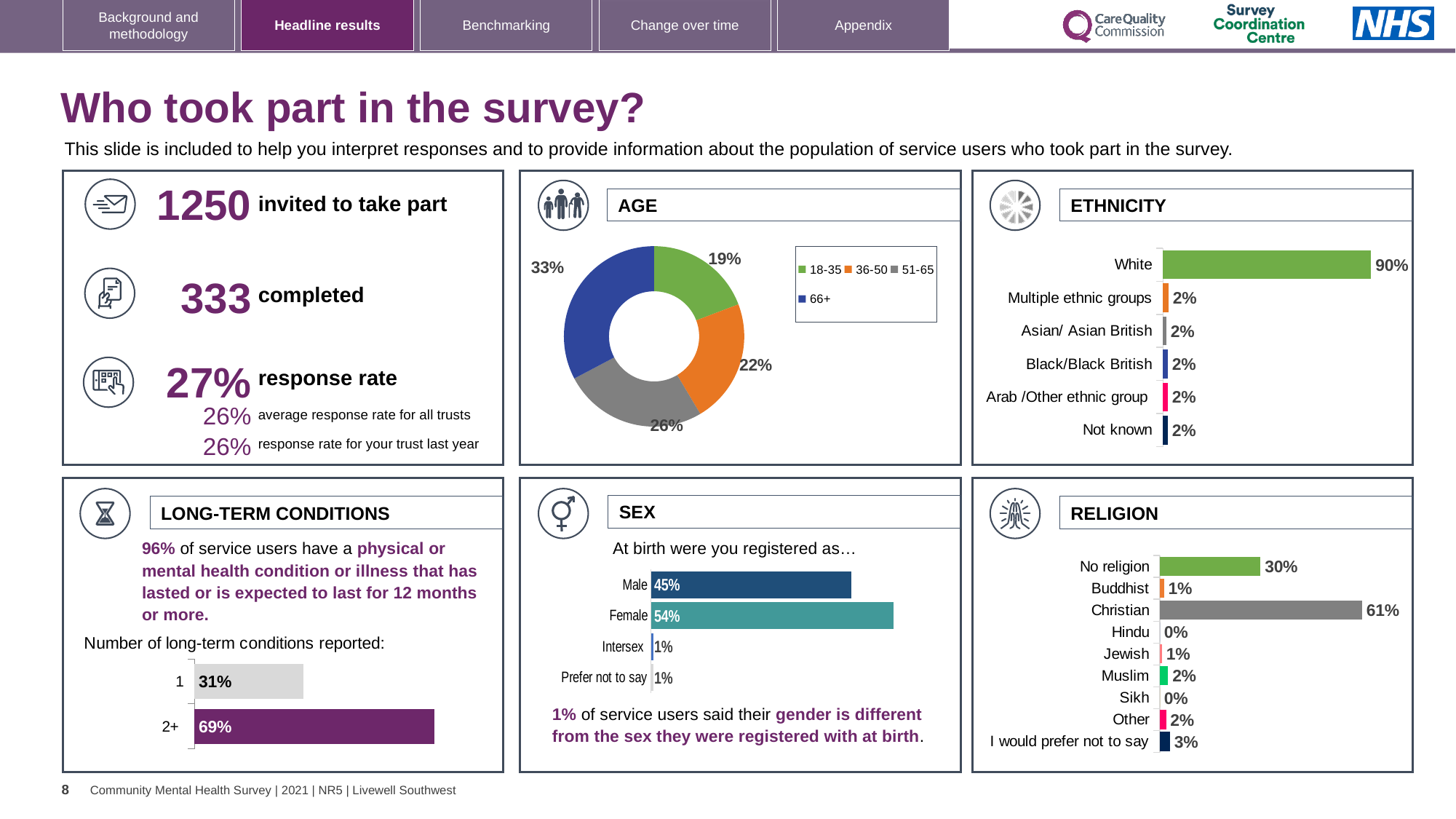
In the SEX chart, what is the value for Intersex? 1% In the ETHNICITY chart, what is the value for White? 90% In the SEX chart, which is larger, the value for Male or the value for Female? Female How many age groups does the legend of the AGE chart list? 4 In the RELIGION chart, what is the difference between the values for Christian and No religion? 31% In the AGE chart, what percentage of respondents were aged 66+? 33% In the RELIGION chart, which religion category has the highest value? Christian In the LONG-TERM CONDITIONS chart, what is the difference between the value for 2+ and the value for 1? 38% What kind of chart is the AGE chart? Donut chart In the RELIGION chart, what is the value for No religion? 30% In the AGE chart, which age group has the smallest share? 18-35 How many ethnicity categories are shown in the ETHNICITY chart? 6